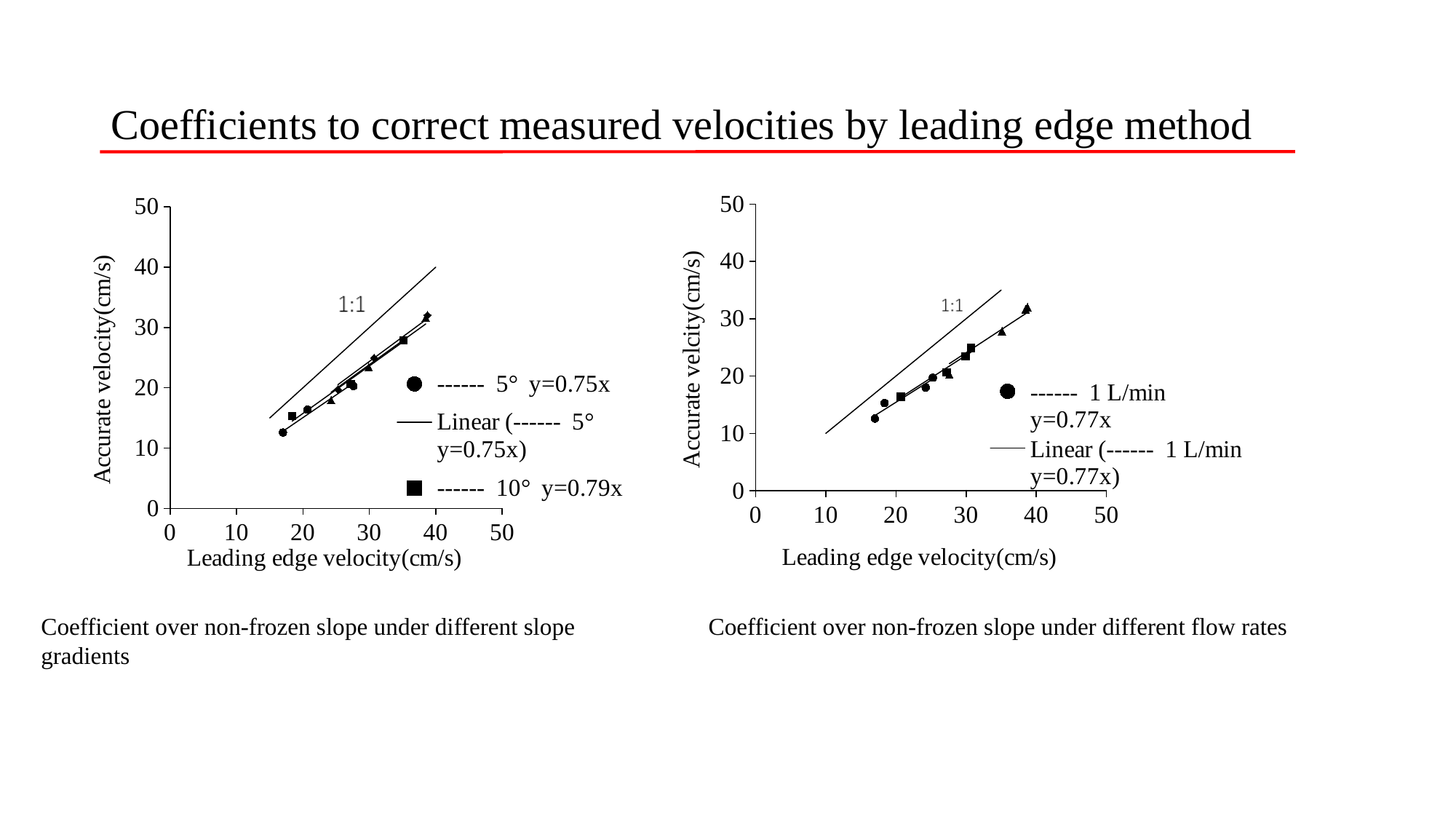
In the right chart (different flow rates), how many entries does the legend list? 2 In the right chart (different flow rates), is the highest plotted accurate velocity greater or less than 40 cm/s? less In the left chart (different slope gradients), do the plotted accurate velocity values rise or fall as leading edge velocity increases? rise What is the x-axis label of the right chart (different flow rates)? Leading edge velocity(cm/s) What label is written next to the diagonal reference line in the left chart (different slope gradients)? 1:1 In the right chart (different flow rates), do the plotted accurate velocity values rise or fall as leading edge velocity increases? rise In the right chart (different flow rates), what fitted equation is given for the 1 L/min series? y=0.77x In the left chart (different slope gradients), what fitted equation is given for the 10° series? y=0.79x In the left chart (different slope gradients), which series has the larger fitted coefficient, 5° or 10°? 10° In the left chart (different slope gradients), is the lowest plotted accurate velocity greater or less than 20 cm/s? less What kind of chart is the left chart, 'Coefficient over non-frozen slope under different slope gradients'? scatter chart In the left chart (different slope gradients), what fitted equation is given for the 5° series? y=0.75x